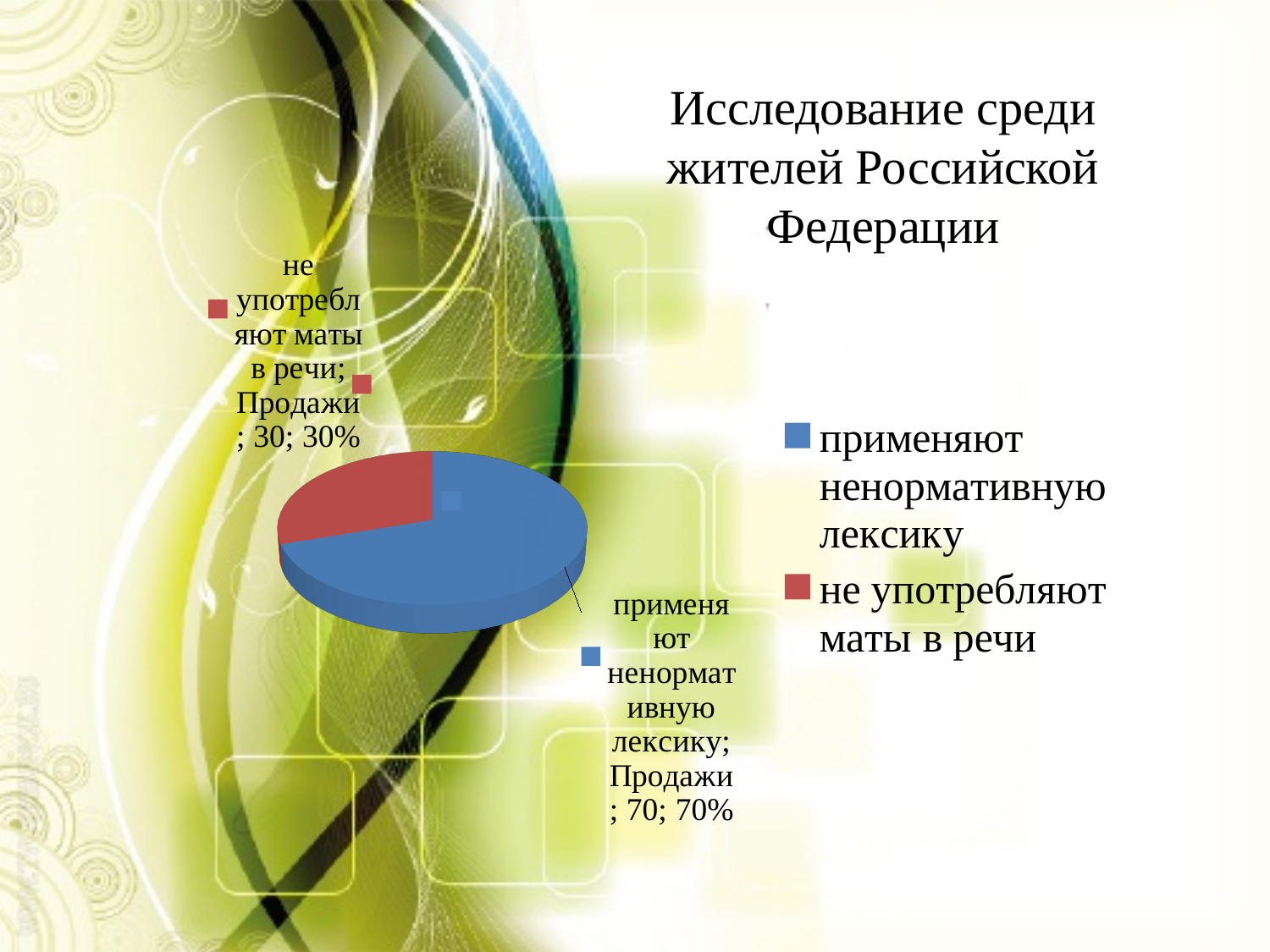
What percentage of the pie is the slice for "применяют ненормативную лексику"? 70% What is the value shown for "не употребляют маты в речи"? 30 How many slices does the pie chart have? 2 What colour is the slice for "не употребляют маты в речи"? red What is the difference between the values for "применяют ненормативную лексику" and "не употребляют маты в речи"? 40 Which category has the largest slice of the pie? применяют ненормативную лексику What kind of chart is shown on the slide? pie chart Which category has the smallest slice of the pie? не употребляют маты в речи What is the value shown for "применяют ненормативную лексику"? 70 What is the title of the chart on the slide? Исследование среди жителей Российской Федерации What percentage of the pie is the slice for "не употребляют маты в речи"? 30% Which is larger: the slice for "применяют ненормативную лексику" or the slice for "не употребляют маты в речи"? применяют ненормативную лексику